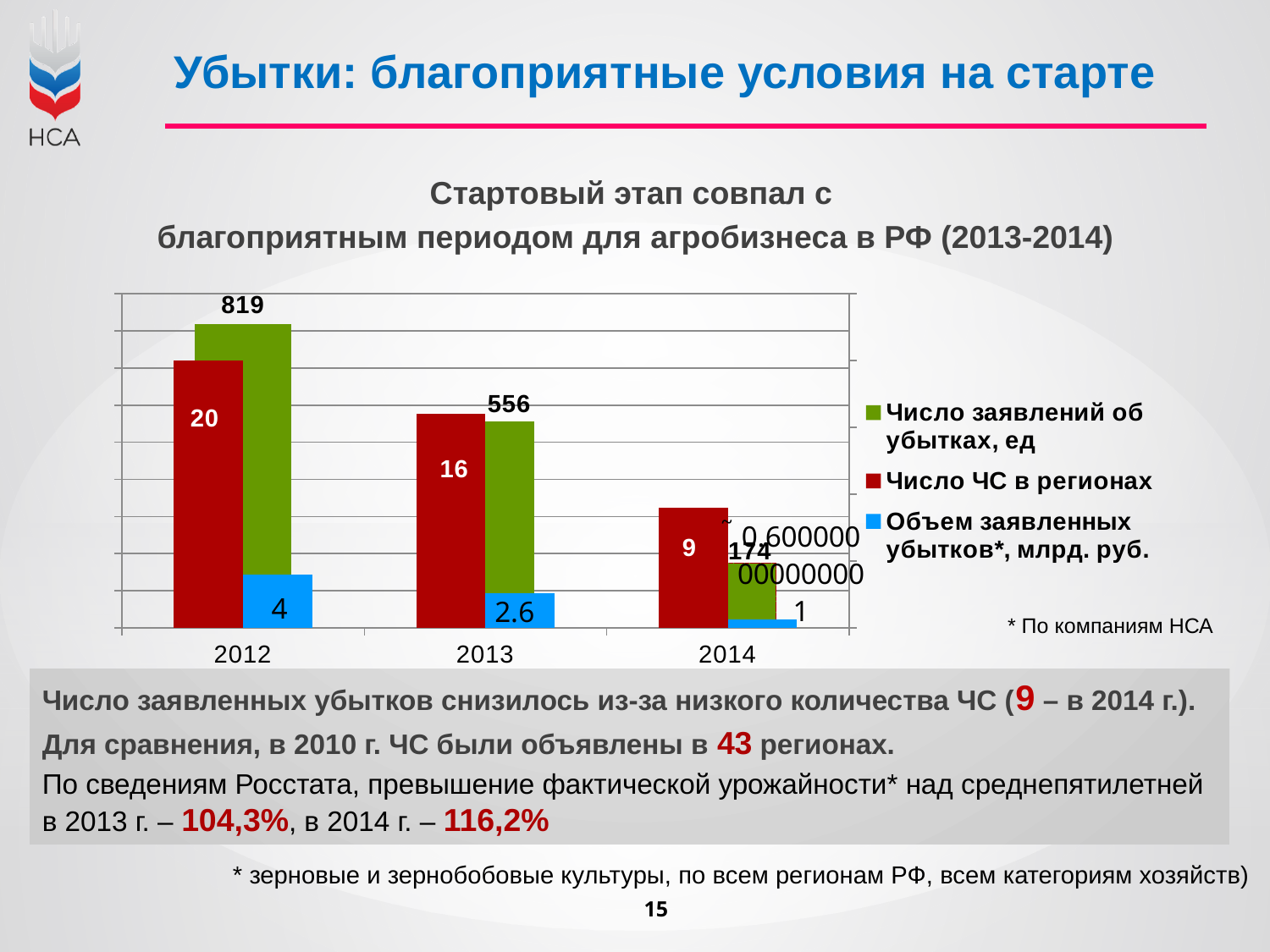
Does "Число заявлений об убытках, ед" rise or fall from 2012 to 2014? fall What is the value of "Число ЧС в регионах" for 2013? 16 What is the difference between "Число заявлений об убытках, ед" in 2012 and 2013? 263 What is the value of "Число заявлений об убытках, ед" for 2012? 819 In which year is "Число заявлений об убытках, ед" highest? 2012 What is the value of "Объем заявленных убытков*, млрд. руб." for 2013? 2.6 How many series does the chart legend list? 3 Which year has the larger value for "Объем заявленных убытков*, млрд. руб.": 2012 or 2013? 2012 What is the value of "Число заявлений об убытках, ед" for 2014? 174 How many years are shown on the x axis of the chart? 3 In which year is "Число ЧС в регионах" lowest? 2014 What is the difference between "Число ЧС в регионах" in 2012 and 2014? 11